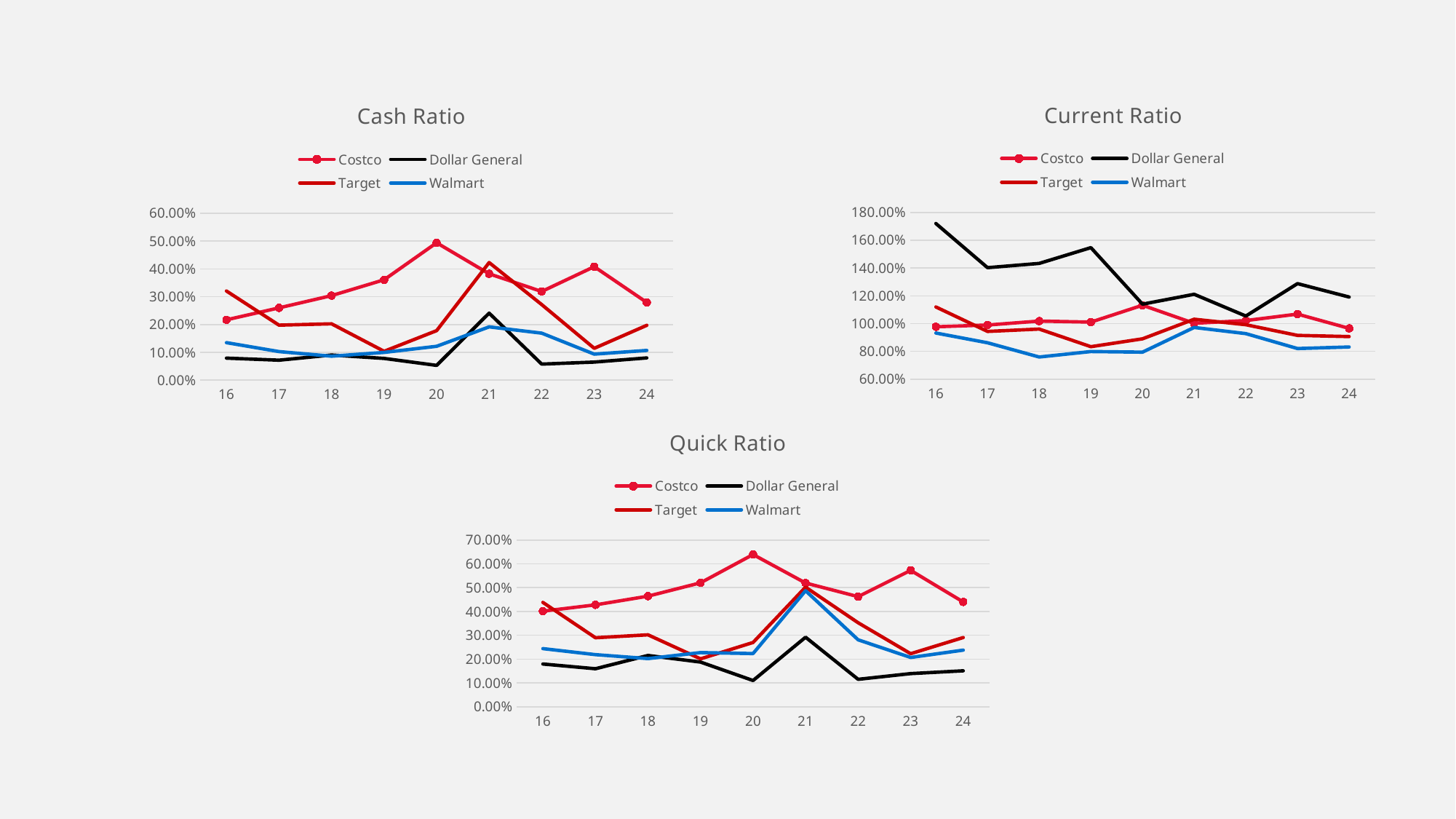
In the Cash Ratio chart, is the value for Dollar General in year 20 greater or less than 10%? less In the Quick Ratio chart, is the value for Costco in year 20 greater or less than 60%? greater In the Cash Ratio chart, is the value for Costco in year 20 greater or less than 40%? greater In the Quick Ratio chart, which series has the lowest value in year 20? Dollar General How many years are plotted along the x axis of the Quick Ratio chart? 9 How many series does the legend of the Current Ratio chart list? 4 In the Quick Ratio chart, which is larger in year 22, Costco or Walmart? Costco In the Current Ratio chart, does the Dollar General line rise or fall from year 16 to year 20? fall What kind of chart is the Cash Ratio chart? line chart In the Current Ratio chart, which series has the highest value in year 16? Dollar General In the Cash Ratio chart, in which year does Costco reach its highest value? 20